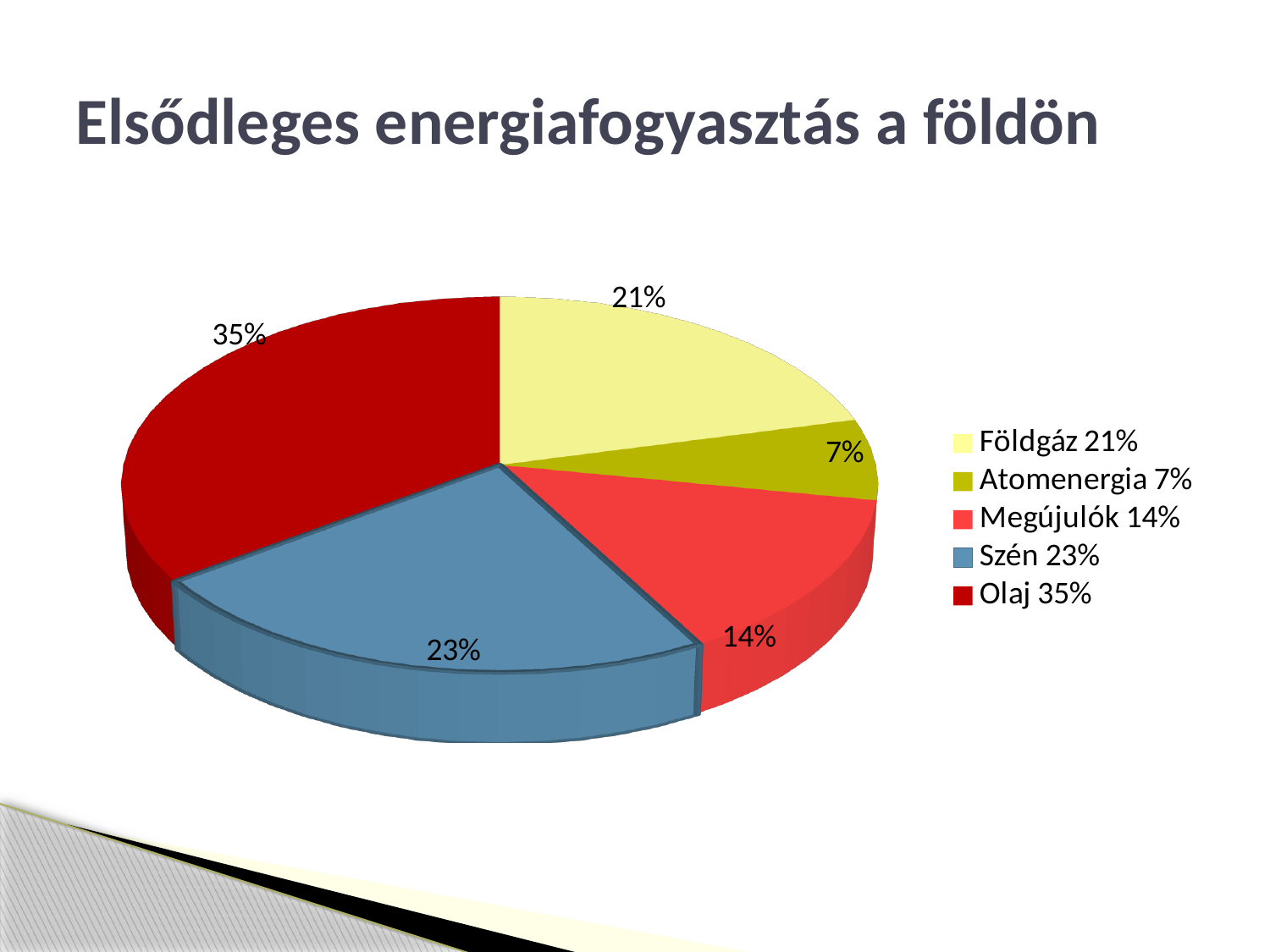
What is the share for Földgáz? 21% What is the title of the slide? Elsődleges energiafogyasztás a földön What is the share for Megújulók? 14% Which has a larger share, Földgáz or Megújulók? Földgáz What type of chart is shown on the slide? Pie chart What colour is the Szén slice? Blue What is the share for Atomenergia? 7% What is the share for Szén? 23% Which category has the smallest share? Atomenergia How many categories does the pie chart have? 5 What is the difference between the shares of Olaj and Szén? 12% Which category has the largest share? Olaj